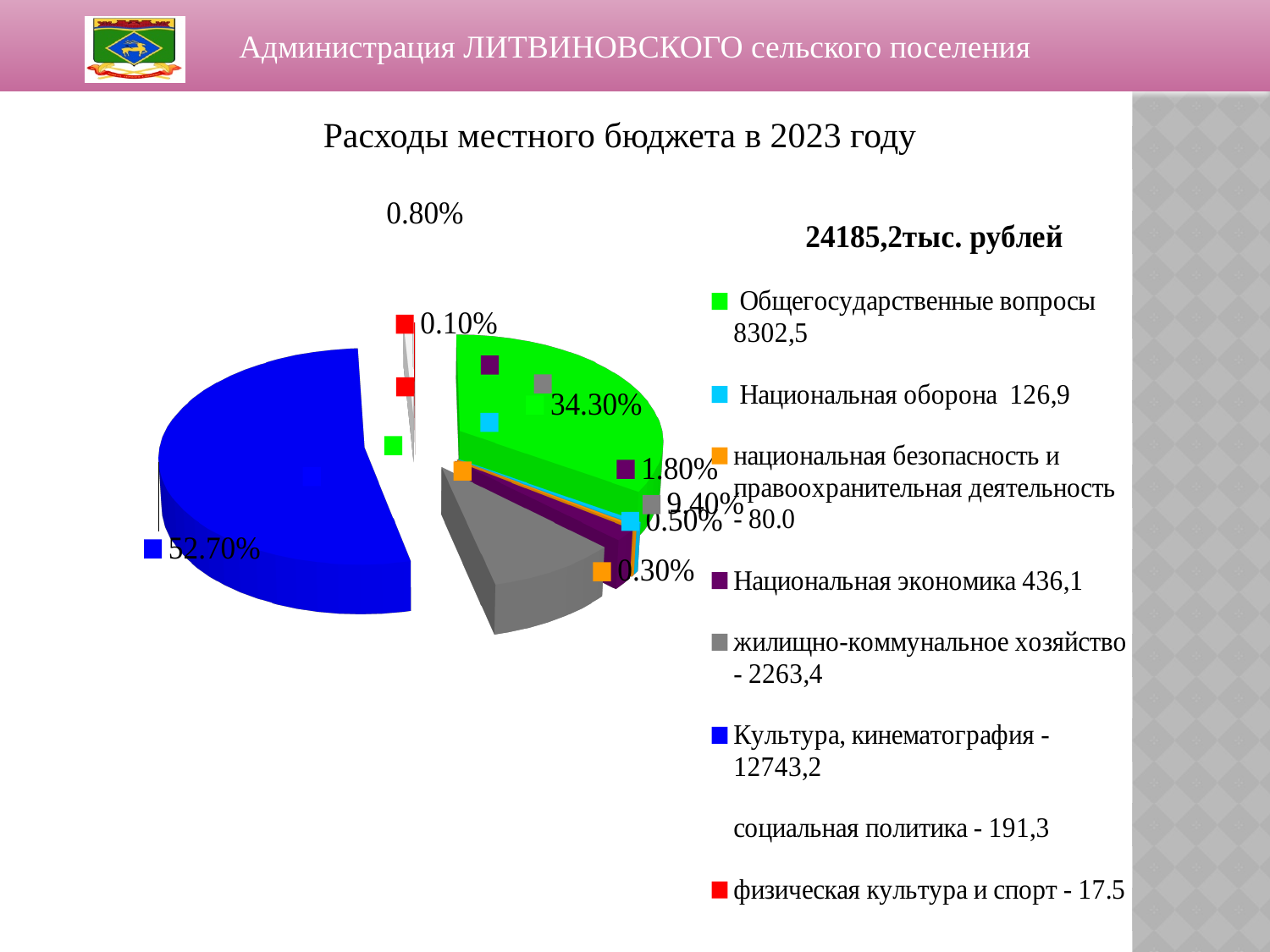
How many categories does the legend list? 8 What percentage share is shown for the red slice (физическая культура и спорт)? 0.10% Which category has the largest share of the pie? Культура, кинематография Which share is larger: Общегосударственные вопросы (34.30%) or жилищно-коммунальное хозяйство (9.40%)? Общегосударственные вопросы What percentage share is shown for the grey slice (жилищно-коммунальное хозяйство)? 9.40% What percentage share is shown for the largest slice (Культура, кинематография)? 52.70% Which category has the smallest share of the pie? физическая культура и спорт What kind of chart is shown on the slide? pie chart What amount is shown in the legend for Культура, кинематография? 12743,2 What percentage share is shown for the green slice (Общегосударственные вопросы)? 34.30% What total amount in thousand rubles is shown above the legend? 24185,2тыс. рублей